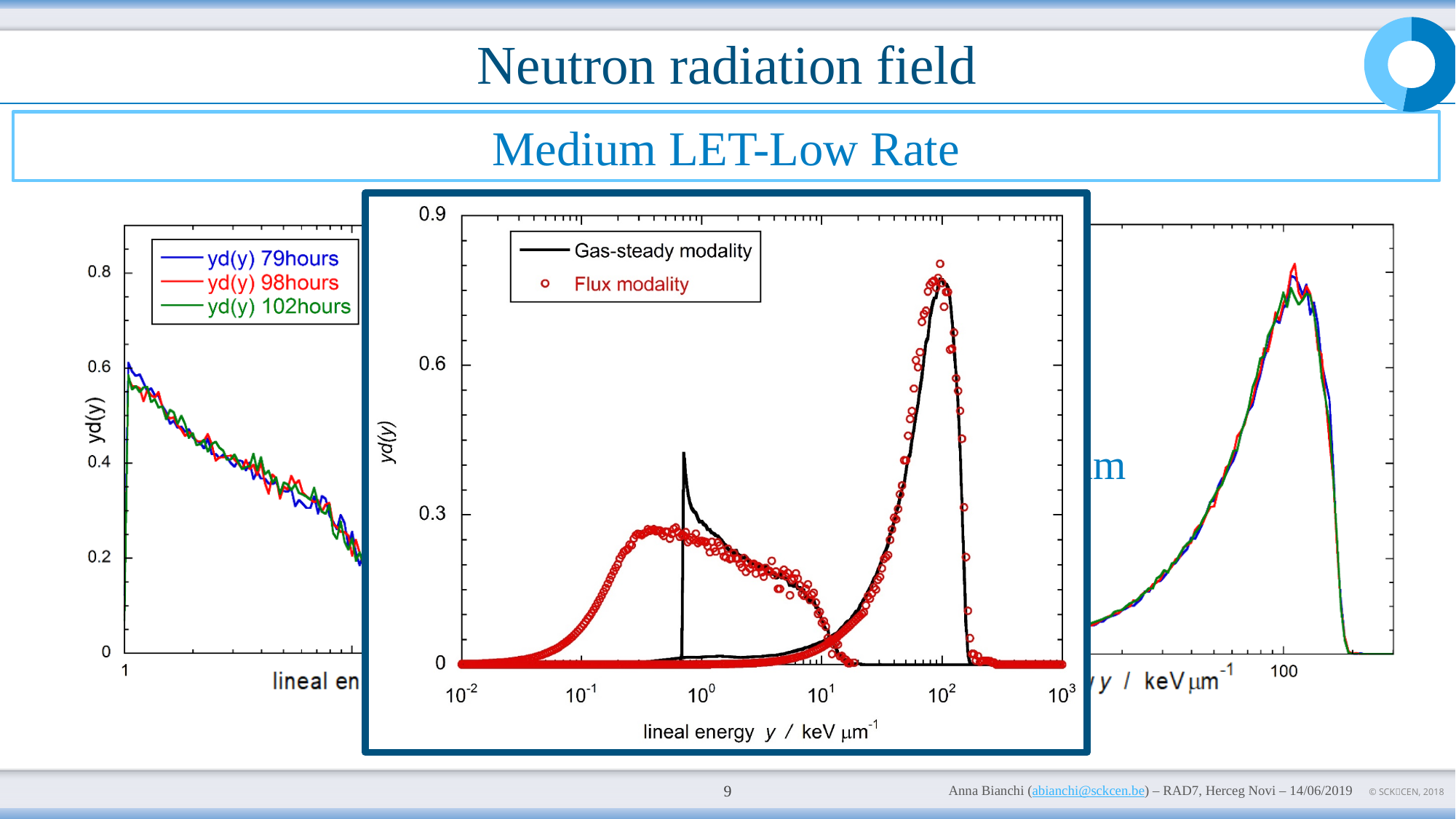
On the left chart, how many series does the legend list? 3 On the center chart, is the Flux modality value at around 0.3 keV μm-1 greater or less than 0.6? less On the left chart, is the value of the yd(y) 79hours curve at lineal energy 1 greater or less than 0.4? greater On the center chart, how many series does the legend list? 2 On the center chart, is the value of the Gas-steady modality curve at 10^-1 keV μm-1 greater or less than 0.3? less What kind of chart is the center chart? line chart On the center chart, what is the x-axis label? lineal energy y / keV μm-1 On the left chart, do the yd(y) values rise or fall as lineal energy increases? fall What kind of chart is the left chart? line chart On the center chart, what is the highest tick value shown on the y axis? 0.9